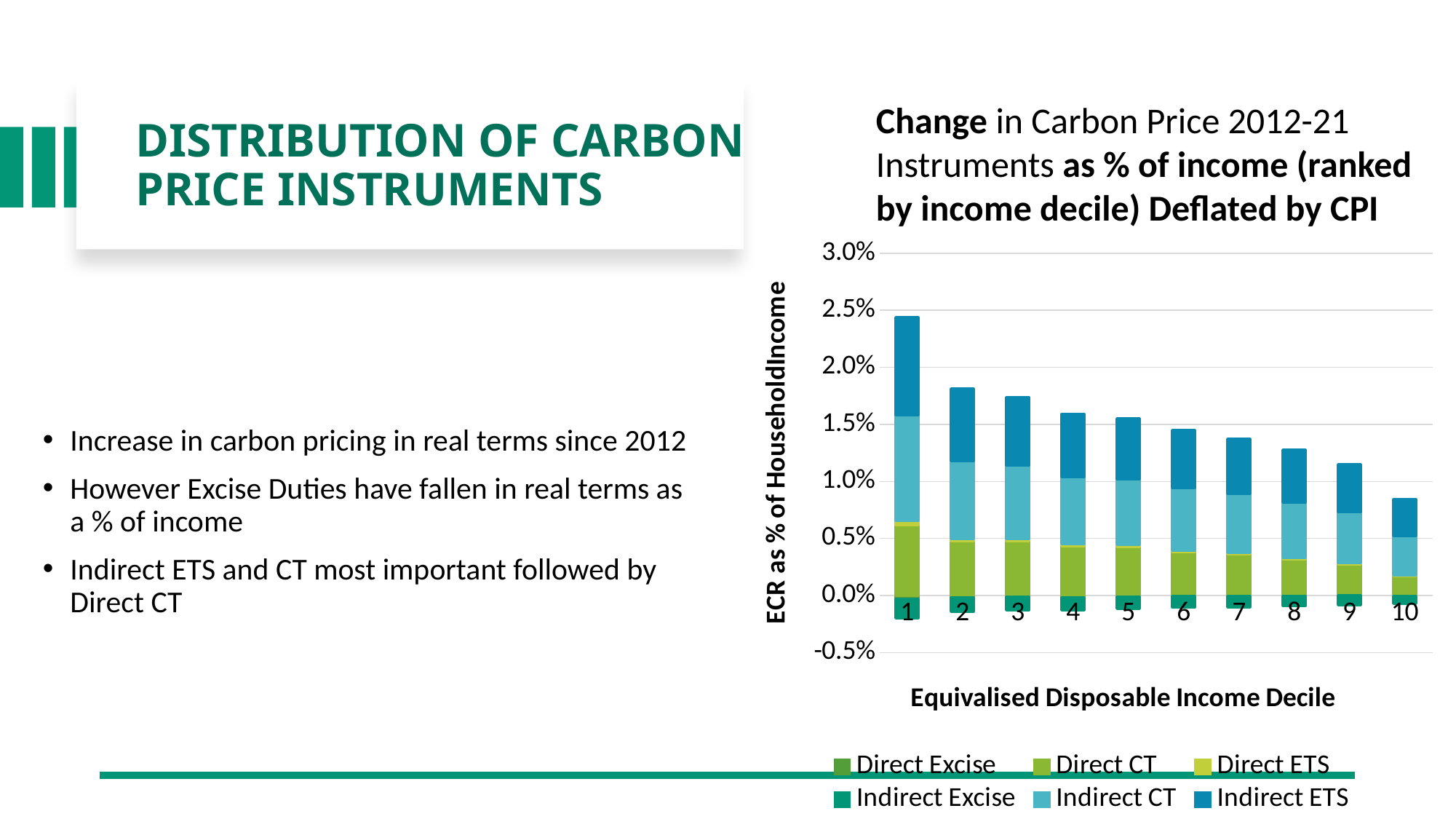
Which has a larger total bar, decile 1 or decile 10? Decile 1 Is the top of the stacked bar for decile 7 greater or less than 1.5%? less What is the label of the chart's x axis? Equivalised Disposable Income Decile Is the top of the stacked bar for decile 1 greater or less than 2.0%? greater Which income decile has the lowest total bar in the chart? 10 Do the total bar heights rise or fall as the income decile increases from 1 to 10? Fall Which income decile has the highest total bar in the chart? 1 Is the top of the stacked bar for decile 10 greater or less than 1.0%? less How many series does the chart's legend list? 6 How many income deciles are shown on the x axis of the chart? 10 What kind of chart is shown on the slide? Stacked bar chart